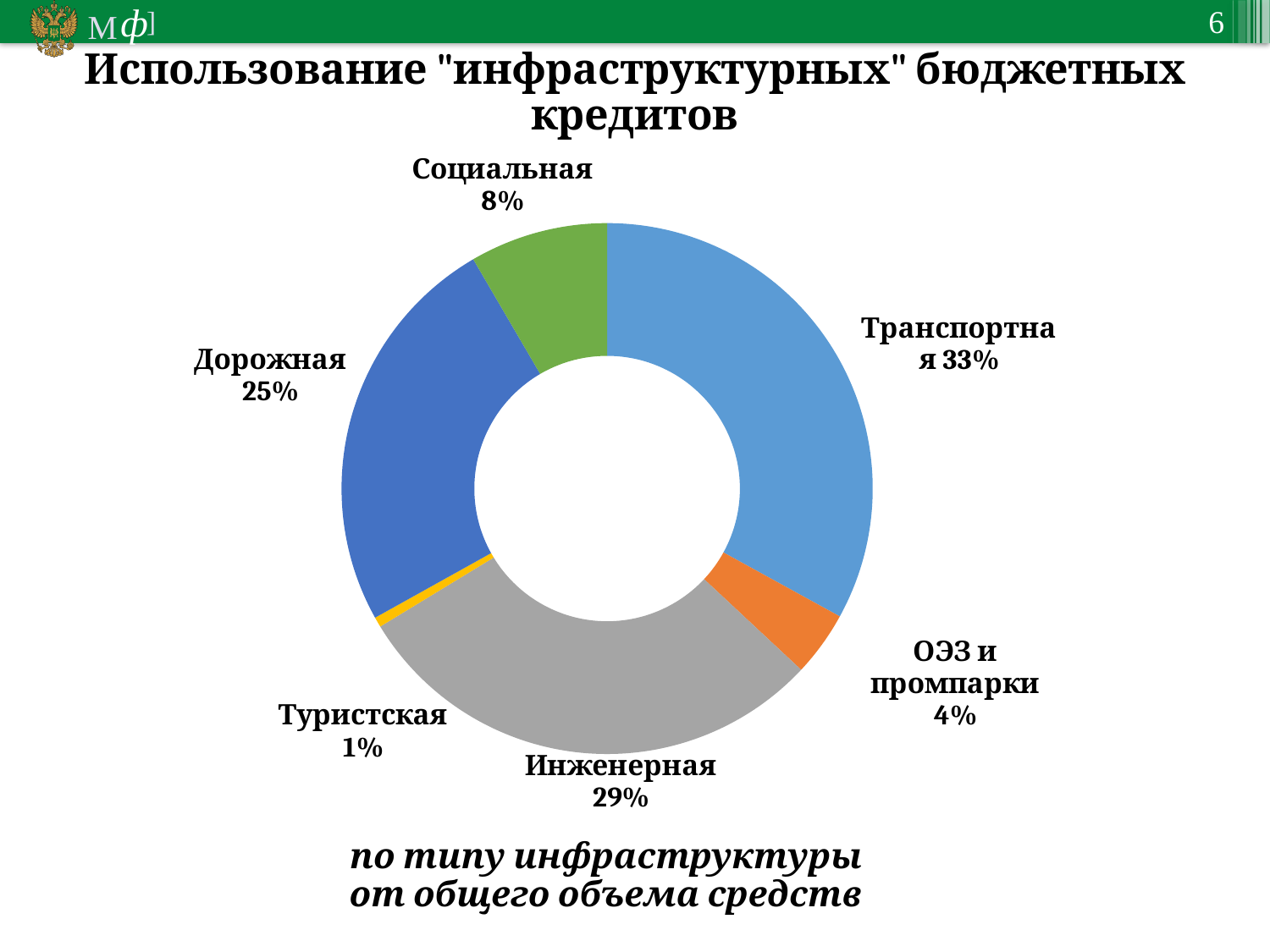
Which has a larger share, Инженерная or Дорожная? Инженерная How many types of infrastructure are shown in the chart? 6 What share of the total does Социальная account for? 8% Which type of infrastructure has the smallest share? Туристская What share of the total does Инженерная account for? 29% Which type of infrastructure has the largest share? Транспортная What share of the total does ОЭЗ и промпарки account for? 4% What share of the total does Транспортная account for? 33% What share of the total does Дорожная account for? 25% What is the difference in percentage points between Транспортная and Дорожная? 8 What kind of chart is shown on the slide? Doughnut (pie) chart What colour is the Инженерная slice? Grey